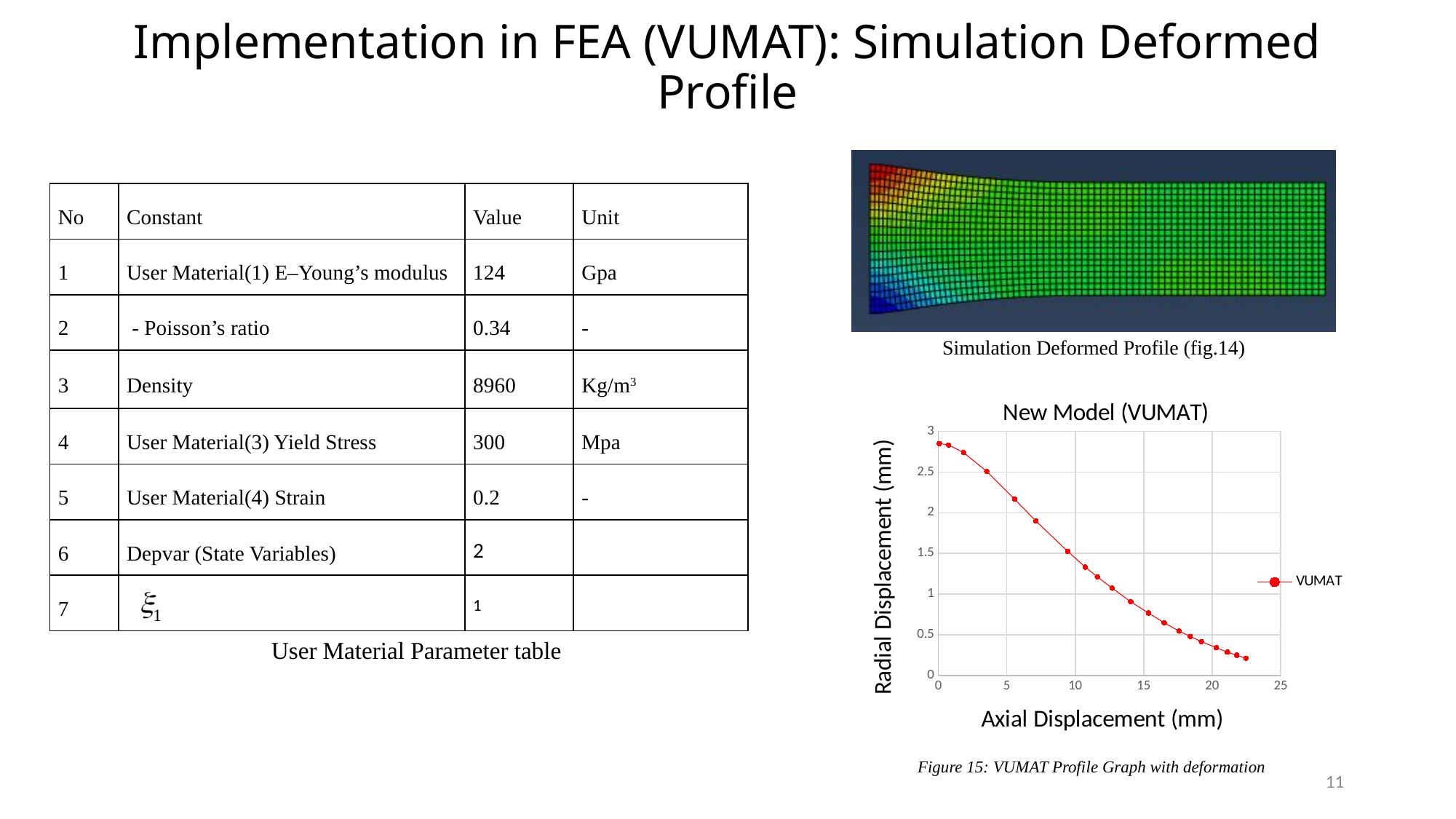
In the "New Model (VUMAT)" chart, is the radial displacement at an axial displacement of 5 mm greater or less than 2? greater What is the name of the series shown in the legend of the "New Model (VUMAT)" chart? VUMAT What kind of chart is the "New Model (VUMAT)" chart? line chart In the "New Model (VUMAT)" chart, is the radial displacement at an axial displacement of 15 mm greater or less than 1? less In the "New Model (VUMAT)" chart, is the radial displacement larger at an axial displacement of 5 mm or at 20 mm? 5 mm In the "New Model (VUMAT)" chart, is the lowest radial displacement found at the left end or the right end of the x axis? right end What is the label of the y axis on the "New Model (VUMAT)" chart? Radial Displacement (mm) In the "New Model (VUMAT)" chart, is the radial displacement at an axial displacement of 20 mm greater or less than 0.5? less Does the radial displacement rise or fall as axial displacement increases along the x axis in the "New Model (VUMAT)" chart? fall In the "New Model (VUMAT)" chart, at which axial displacement value is the radial displacement highest? 0 mm How many series does the legend of the "New Model (VUMAT)" chart list? 1